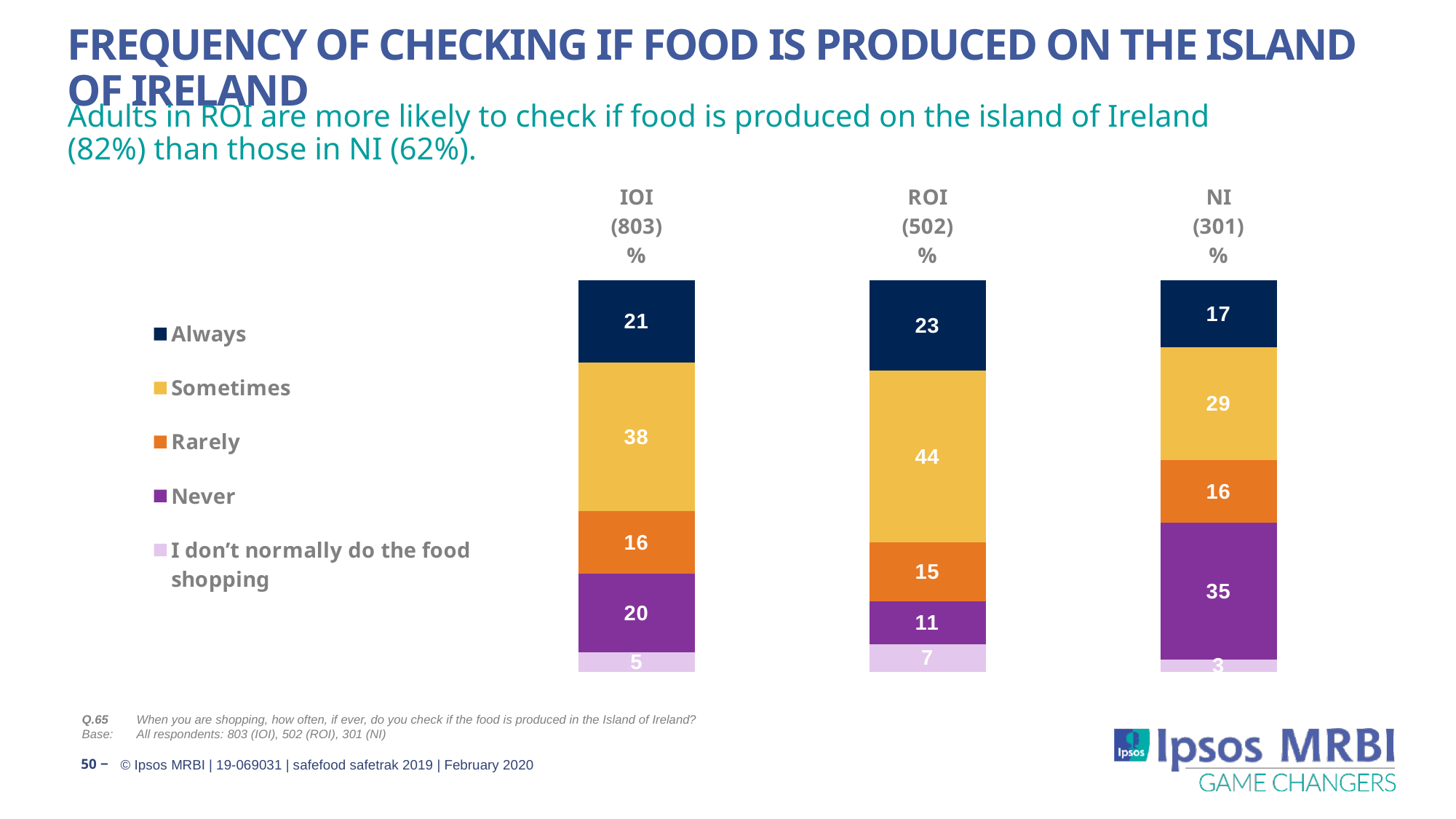
What is the 'Always' value for IOI? 21 What is the difference between the 'Never' values for NI and ROI? 24 What is the total of the ROI stacked bar? 100 What is the 'Never' value for NI? 35 What is the value for 'I don't normally do the food shopping' in the NI bar? 3 What kind of chart is shown on the slide? Stacked bar chart What percentage of ROI adults say they 'Sometimes' check if food is produced on the island of Ireland? 44 Which of the three bars has the lowest 'Sometimes' value? NI How many bars are shown in the chart? 3 How many series does the legend list? 5 Which of the three bars has the highest 'Always' value? ROI Is the 'Rarely' value larger for IOI or for ROI? IOI